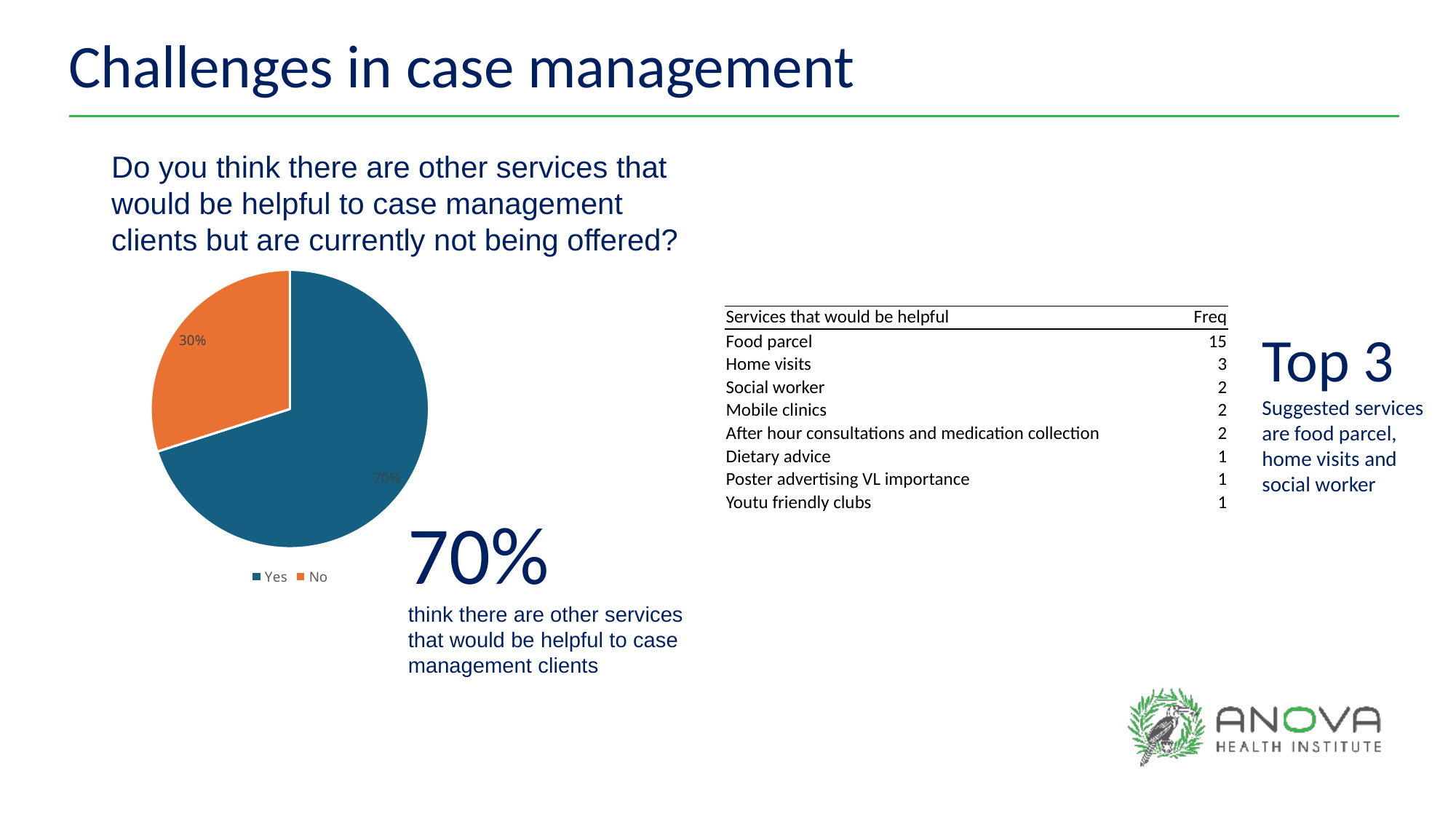
What share of the pie chart is labelled Yes? 70% How many slices does the pie chart have? 2 Which slice is larger in the pie chart, Yes or No? Yes What colour is the No slice in the pie chart? orange What is the difference in percentage points between the Yes and No slices of the pie chart? 40 What share of the pie chart is labelled No? 30% What colour is the Yes slice in the pie chart? blue What kind of chart is shown on the slide? pie chart Which slice of the pie chart is the smallest? No Which slice of the pie chart is the largest? Yes How many entries does the pie chart's legend list? 2